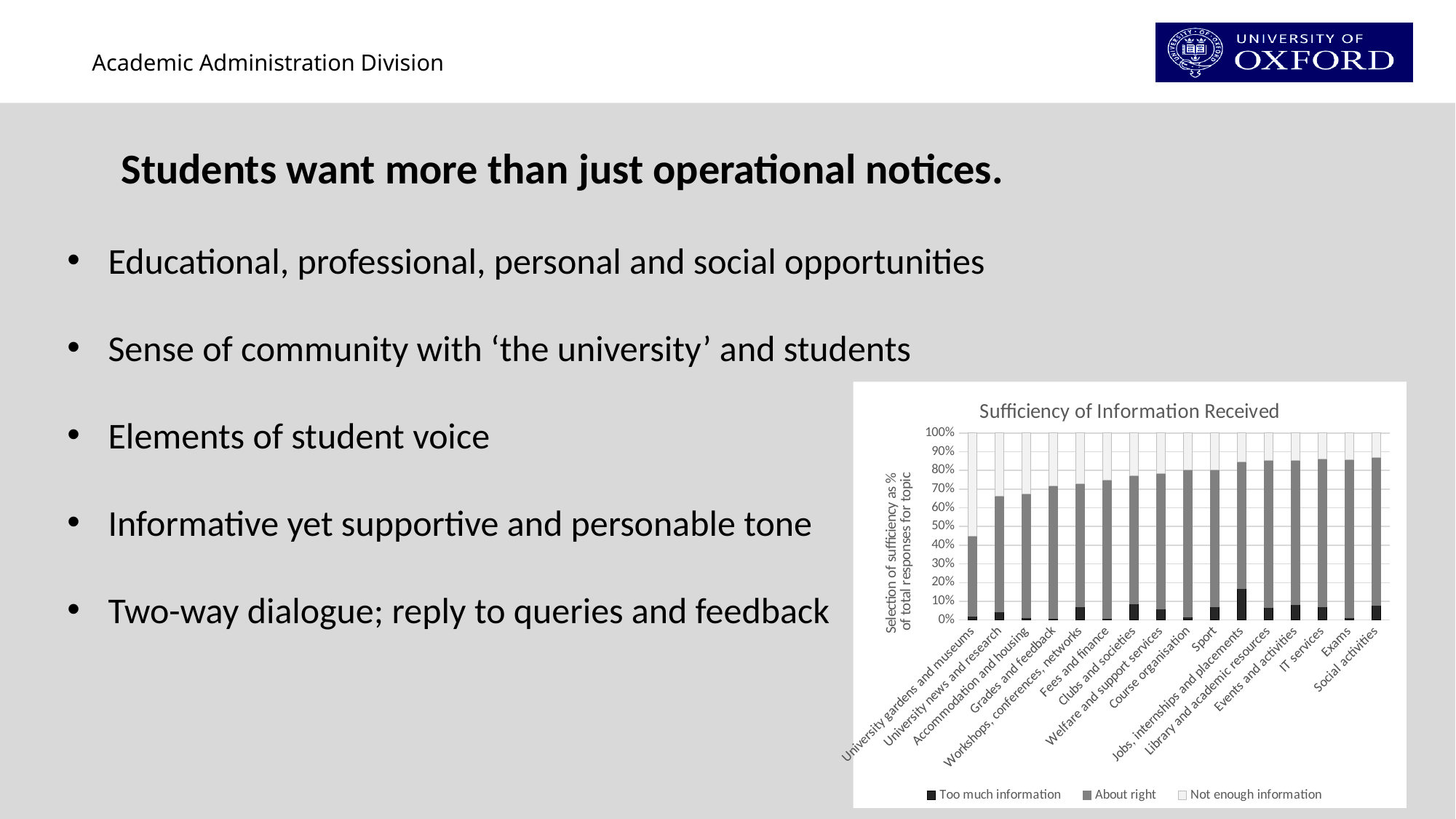
Is the 'Too much information' share for Jobs, internships and placements greater or less than 10%? greater Moving from left to right along the x axis, does the combined share of 'Too much information' and 'About right' rise or fall? rise Is the 'Not enough information' share larger for University gardens and museums or for Social activities? University gardens and museums Is the combined share of 'Too much information' and 'About right' for Social activities greater or less than 80%? greater What type of chart is shown on the slide? Stacked bar chart Is the top of the 'About right' segment for University gardens and museums greater or less than 50%? less How many topic categories are shown along the x axis of the chart? 16 Which category has the largest 'Too much information' share in the chart? Jobs, internships and placements What is the label on the chart's vertical axis? Selection of sufficiency as % of total responses for topic Which category has the largest 'Not enough information' share in the chart? University gardens and museums How many series does the chart's legend list? 3 What is the title of the chart on the slide? Sufficiency of Information Received